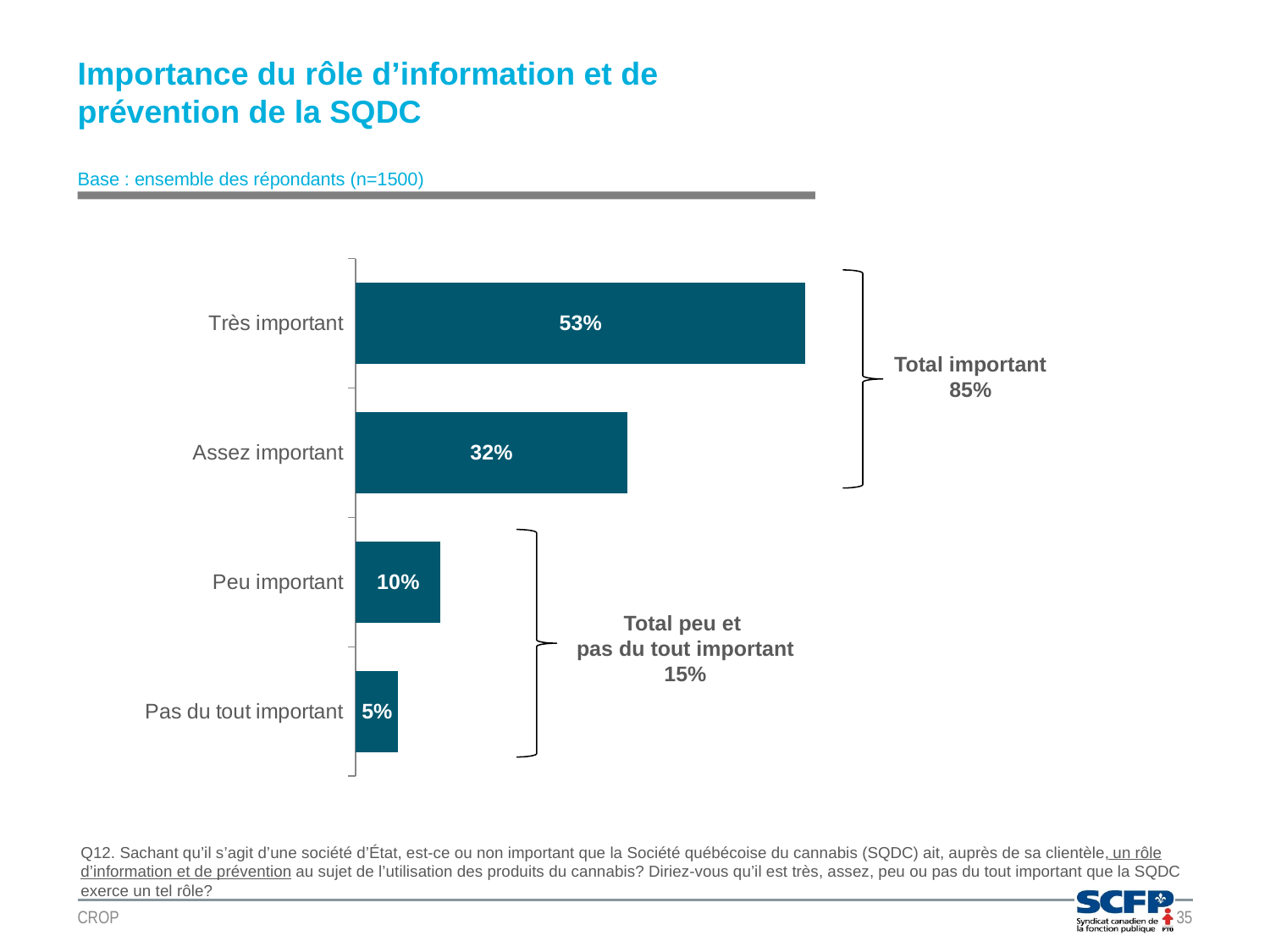
What is the value for "Assez important"? 32% Which category has the highest value? Très important What is the difference between the values for "Très important" and "Assez important"? 21% Which is larger, the value for "Peu important" or the value for "Pas du tout important"? Peu important What kind of chart is shown on the slide? Bar chart What is the "Total important" value shown next to the bracket? 85% What is the "Total peu et pas du tout important" value shown next to the bracket? 15% Which category has the lowest value? Pas du tout important What is the value for "Peu important"? 10% How many categories are shown in the chart? 4 What is the value for "Très important"? 53% What is the value for "Pas du tout important"? 5%